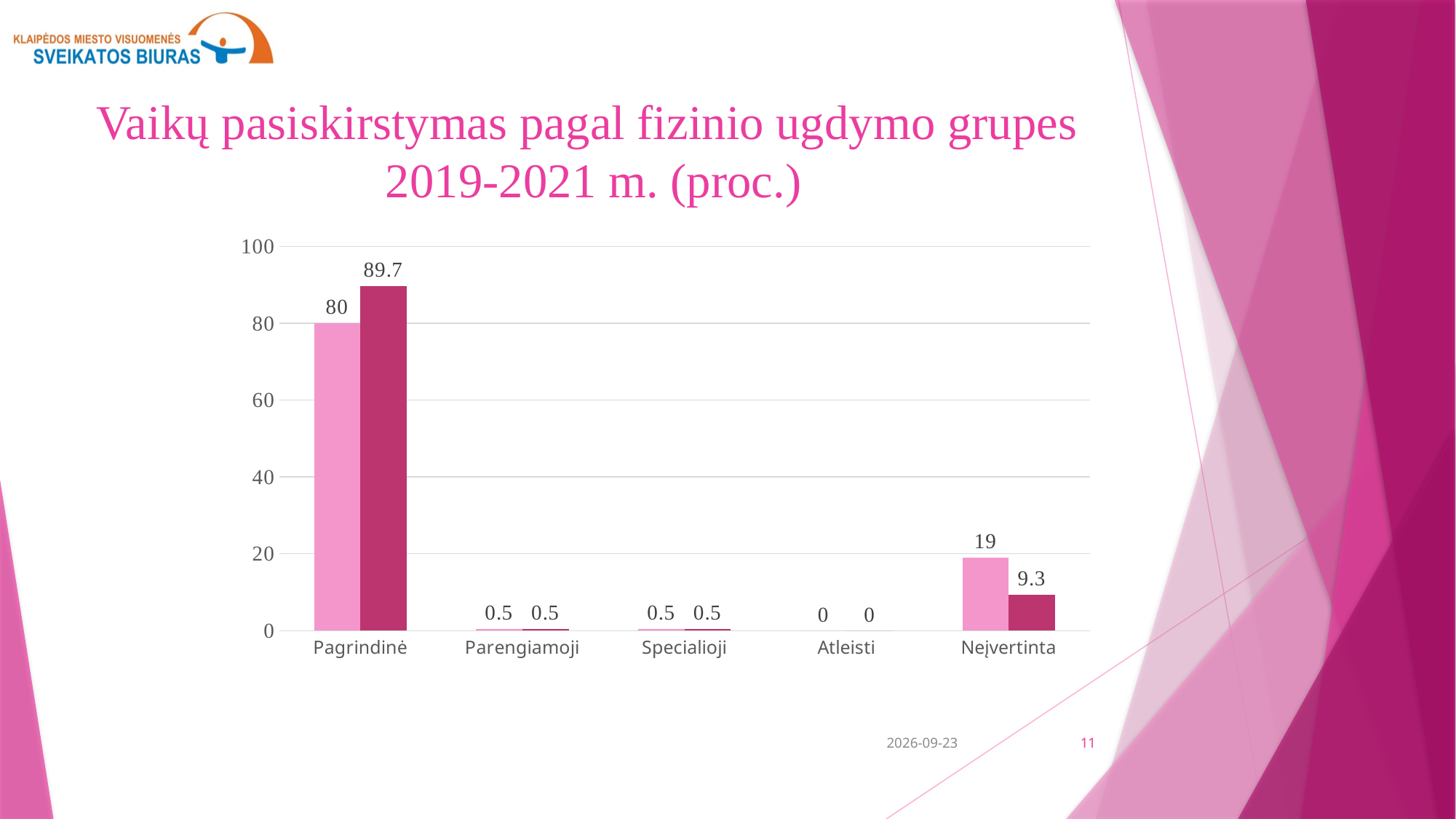
What is the difference between the light pink and dark magenta bars for Neįvertinta? 9.7 Which category has the lowest values in the chart? Atleisti How many categories are shown on the x axis? 5 For Neįvertinta, which bar is larger, the light pink or the dark magenta one? light pink What is the value of the light pink bar for Neįvertinta? 19 What is the difference between the dark magenta and light pink bars for Pagrindinė? 9.7 What is the value of the dark magenta bar for Neįvertinta? 9.3 What type of chart is shown on the slide? bar chart What is the value of the dark magenta bar for Pagrindinė? 89.7 Which category has the highest value in the chart? Pagrindinė What is the value of the light pink bar for Pagrindinė? 80 What value is shown for Atleisti for both bars? 0